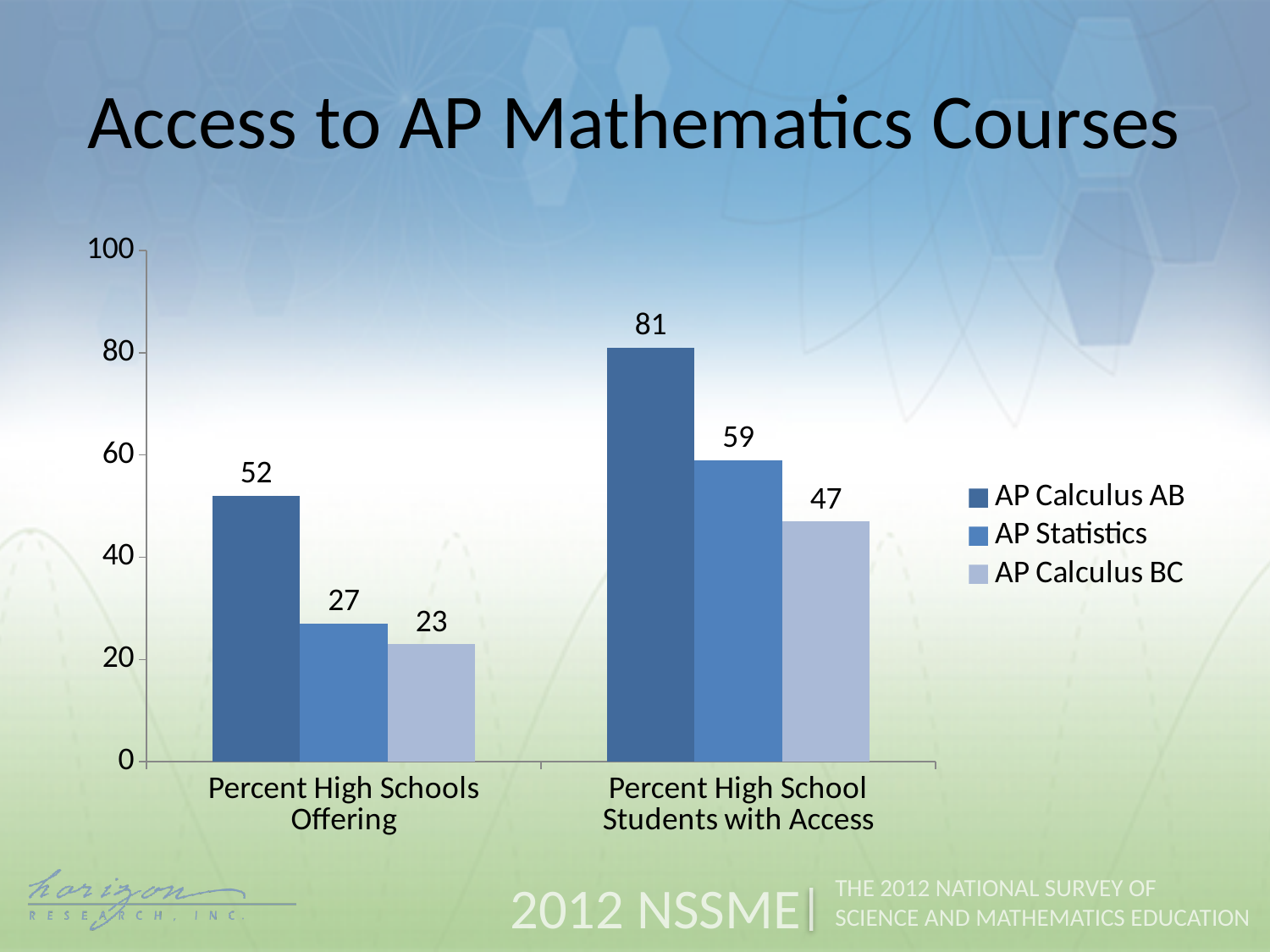
What is the value for AP Calculus BC in the Percent High Schools Offering category? 23 How many series does the legend list? 3 What is the difference between the AP Calculus AB values for Percent High School Students with Access and Percent High Schools Offering? 29 Which series has the lowest value in the Percent High Schools Offering category? AP Calculus BC Is the value for AP Calculus BC in the Percent High School Students with Access category greater or less than 40? greater How many categories are shown on the x axis? 2 What is the value for AP Statistics in the Percent High School Students with Access category? 59 Which series has the highest value in the Percent High School Students with Access category? AP Calculus AB Which is larger: the AP Statistics value for Percent High Schools Offering or the AP Calculus BC value for Percent High School Students with Access? AP Calculus BC value for Percent High School Students with Access What is the value for AP Calculus AB in the Percent High Schools Offering category? 52 What kind of chart is shown on the slide? bar chart What is the title of the slide? Access to AP Mathematics Courses